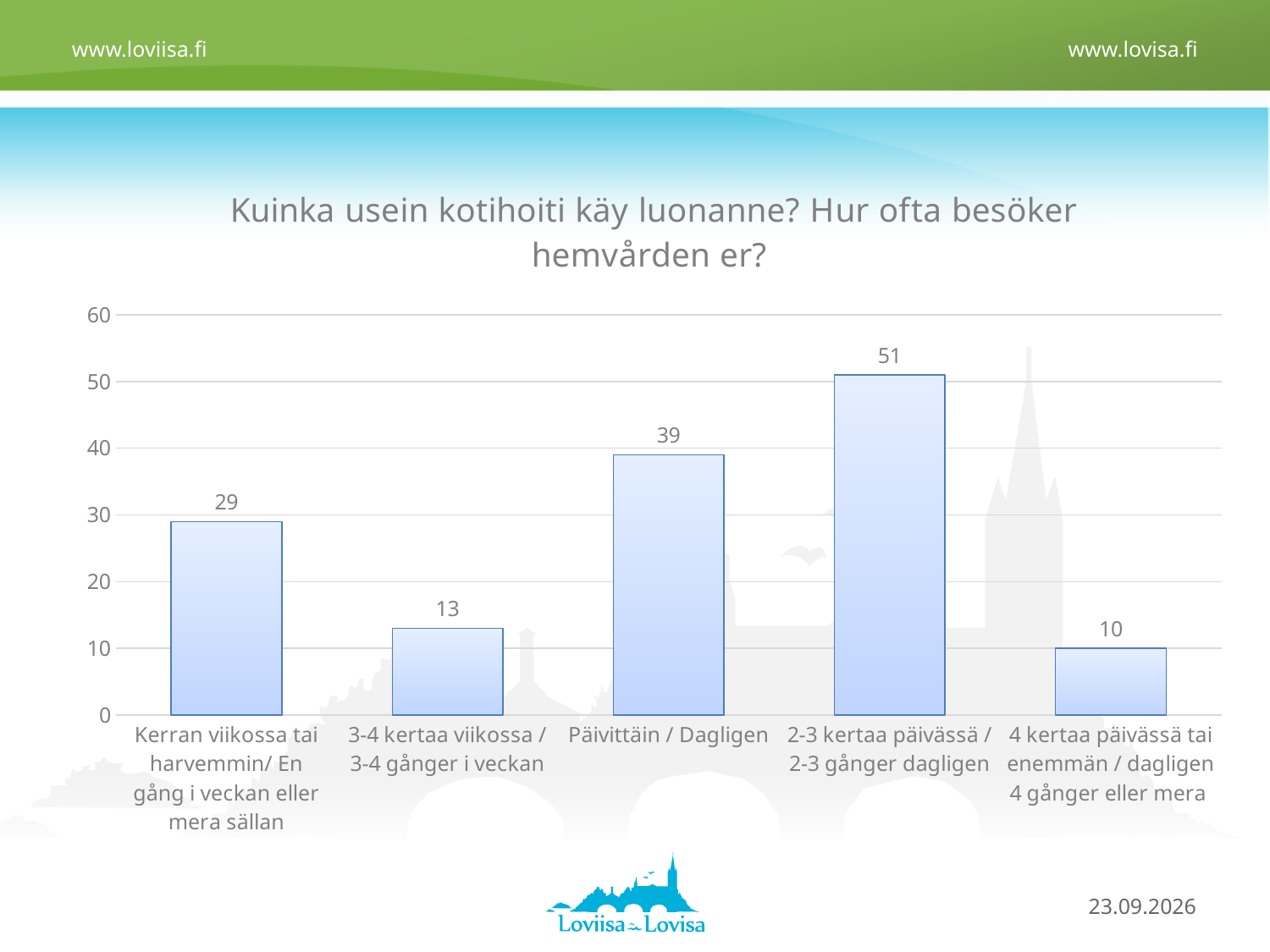
Which is larger, the value for "Kerran viikossa tai harvemmin" or the value for "3-4 kertaa viikossa"? Kerran viikossa tai harvemmin What is the value for "Päivittäin / Dagligen"? 39 Is the value for "Päivittäin / Dagligen" greater or less than 30? greater What is the highest value shown on the y axis? 60 What is the difference between the values for "2-3 kertaa päivässä / 2-3 gånger dagligen" and "Päivittäin / Dagligen"? 12 Which category has the highest value? 2-3 kertaa päivässä / 2-3 gånger dagligen What is the title of the chart? Kuinka usein kotihoiti käy luonanne? Hur ofta besöker hemvården er? Which category has the lowest value? 4 kertaa päivässä tai enemmän / dagligen 4 gånger eller mera What is the value for "Kerran viikossa tai harvemmin/ En gång i veckan eller mera sällan"? 29 How many categories are shown on the x axis? 5 What is the value for "3-4 kertaa viikossa / 3-4 gånger i veckan"? 13 What kind of chart is shown on the slide? bar chart